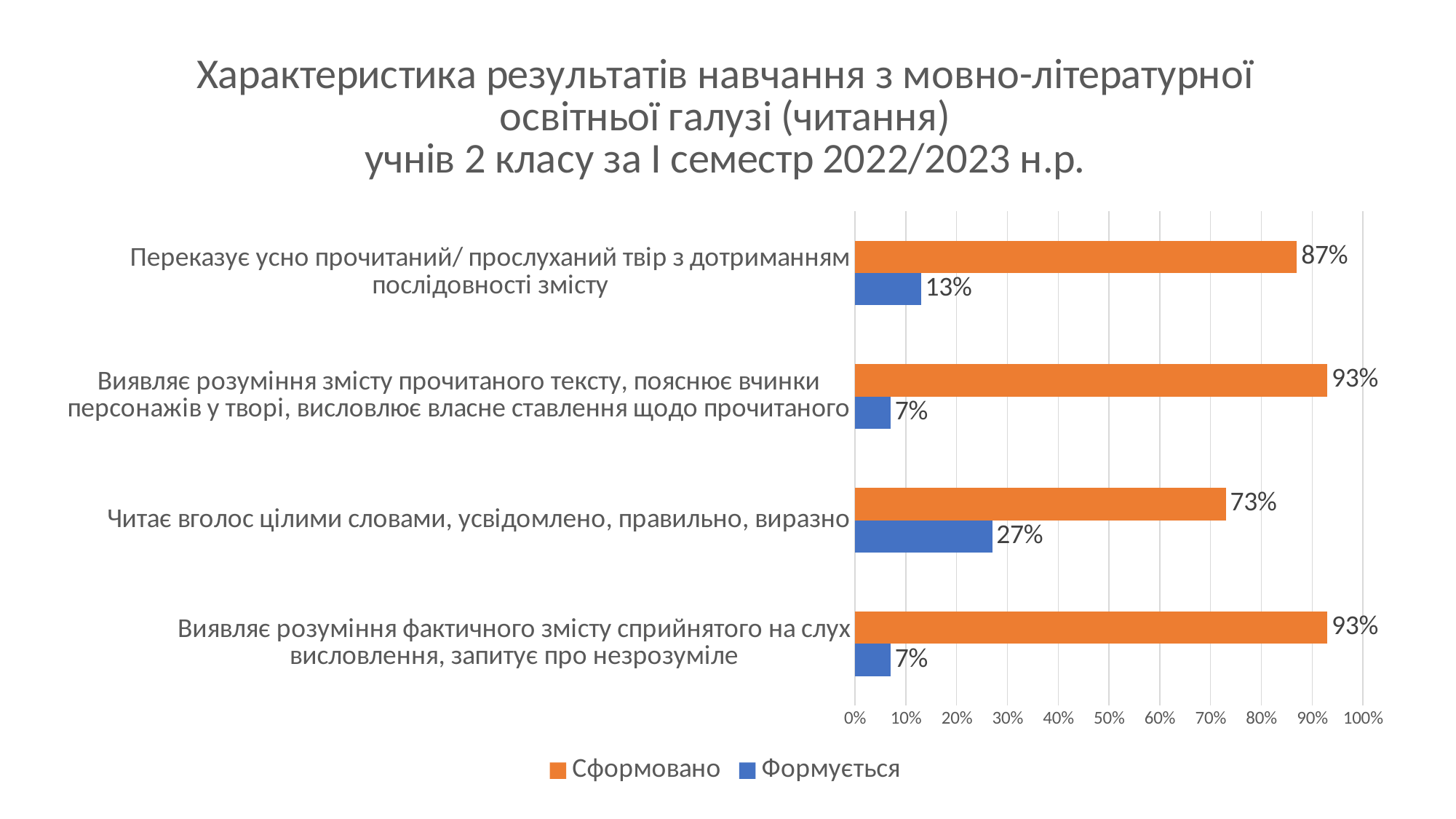
Which colour represents the 'Формується' series? Blue What is the difference between the 'Сформовано' and 'Формується' values for 'Переказує усно прочитаний/ прослуханий твір з дотриманням послідовності змісту'? 74% How many series does the legend list? 2 Which category has the lowest 'Сформовано' value? Читає вголос цілими словами, усвідомлено, правильно, виразно What is the 'Формується' value for 'Переказує усно прочитаний/ прослуханий твір з дотриманням послідовності змісту'? 13% What is the 'Формується' value for 'Виявляє розуміння змісту прочитаного тексту, пояснює вчинки персонажів у творі, висловлює власне ставлення щодо прочитаного'? 7% What is the 'Сформовано' value for 'Читає вголос цілими словами, усвідомлено, правильно, виразно'? 73% What is the 'Сформовано' value for 'Виявляє розуміння фактичного змісту сприйнятого на слух висловлення, запитує про незрозуміле'? 93% How many categories are shown on the chart? 4 Which is larger: the 'Сформовано' value for 'Читає вголос цілими словами, усвідомлено, правильно, виразно' or for 'Переказує усно прочитаний/ прослуханий твір з дотриманням послідовності змісту'? Переказує усно прочитаний/ прослуханий твір з дотриманням послідовності змісту Which category has the highest 'Формується' value? Читає вголос цілими словами, усвідомлено, правильно, виразно What kind of chart is shown on the slide? Bar chart